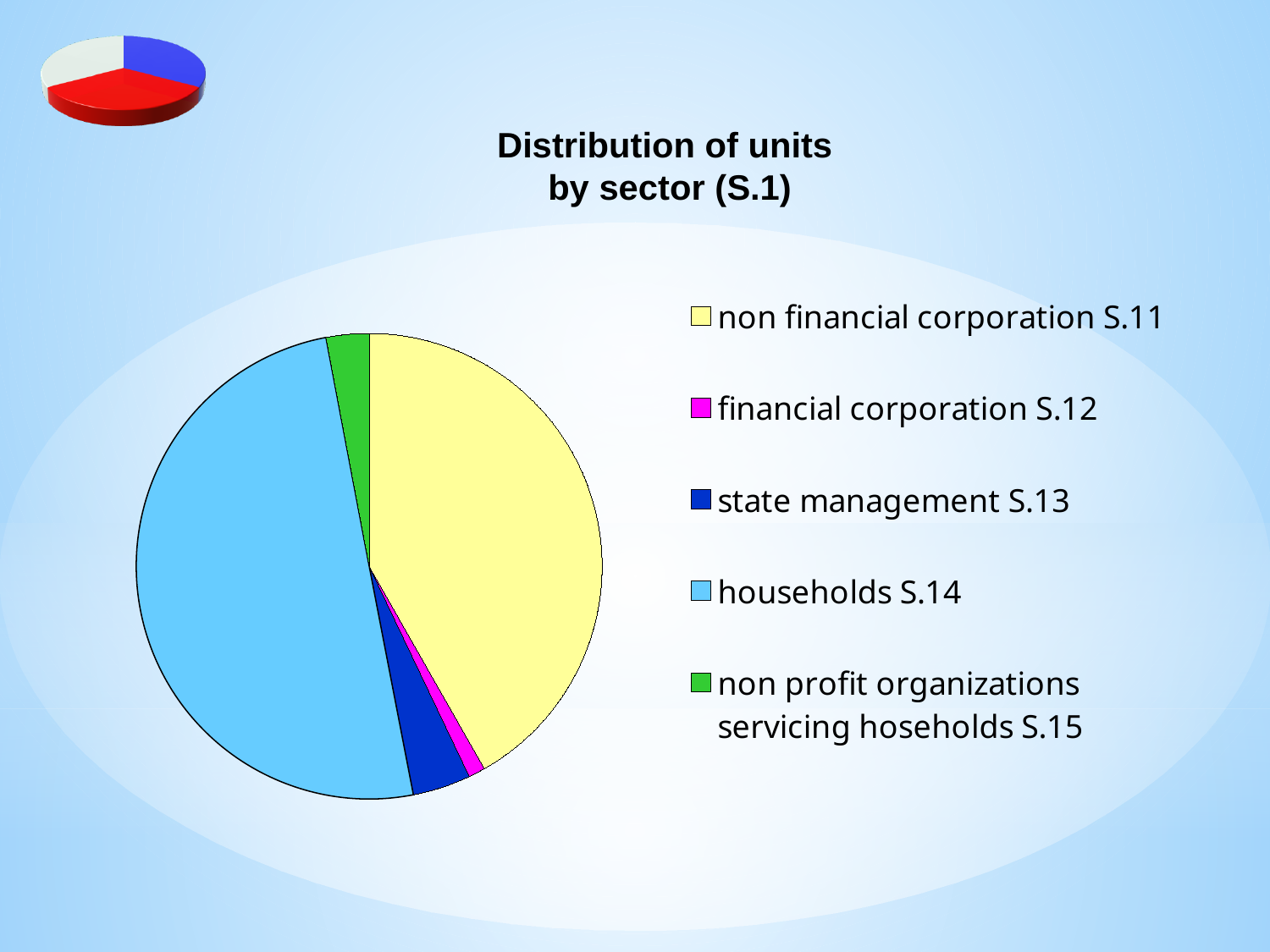
Which slice is larger: non financial corporation S.11 or non profit organizations servicing hoseholds S.15? non financial corporation S.11 How many entries does the legend list? 5 Which slice is larger: state management S.13 or financial corporation S.12? state management S.13 Which sector has the smallest slice of the pie? financial corporation S.12 What kind of chart is shown on the slide? pie chart How many sectors (slices) does the pie chart show? 5 Which colour represents households S.14 in the pie chart? light blue Which slice is larger: households S.14 or state management S.13? households S.14 What is the title of the chart? Distribution of units by sector (S.1)